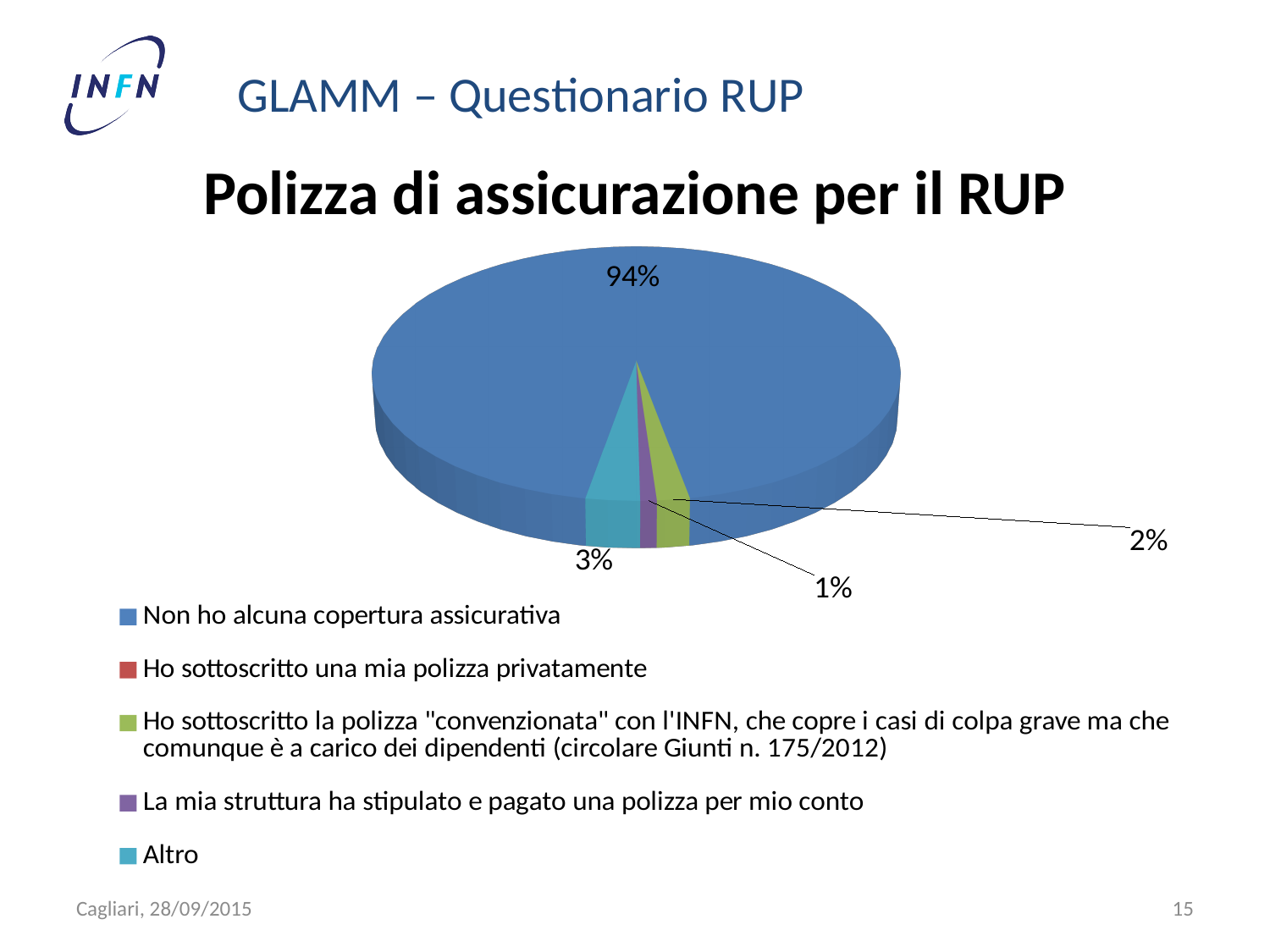
What is the difference in percentage points between "Non ho alcuna copertura assicurativa" and "Altro"? 91 What is the title of the chart? Polizza di assicurazione per il RUP What kind of chart is shown on the slide? pie chart What percentage of the pie corresponds to "Non ho alcuna copertura assicurativa"? 94% What percentage of the pie corresponds to "La mia struttura ha stipulato e pagato una polizza per mio conto"? 1% What percentage of the pie corresponds to "Ho sottoscritto la polizza "convenzionata" con l'INFN"? 2% How many entries does the legend list? 5 What colour is the largest slice of the pie? blue What is the difference in percentage points between "Altro" and "La mia struttura ha stipulato e pagato una polizza per mio conto"? 2 What percentage of the pie corresponds to "Altro"? 3% Which is larger: the slice for "Altro" or the slice for "Ho sottoscritto la polizza "convenzionata" con l'INFN"? Altro Which category has the largest slice of the pie? Non ho alcuna copertura assicurativa